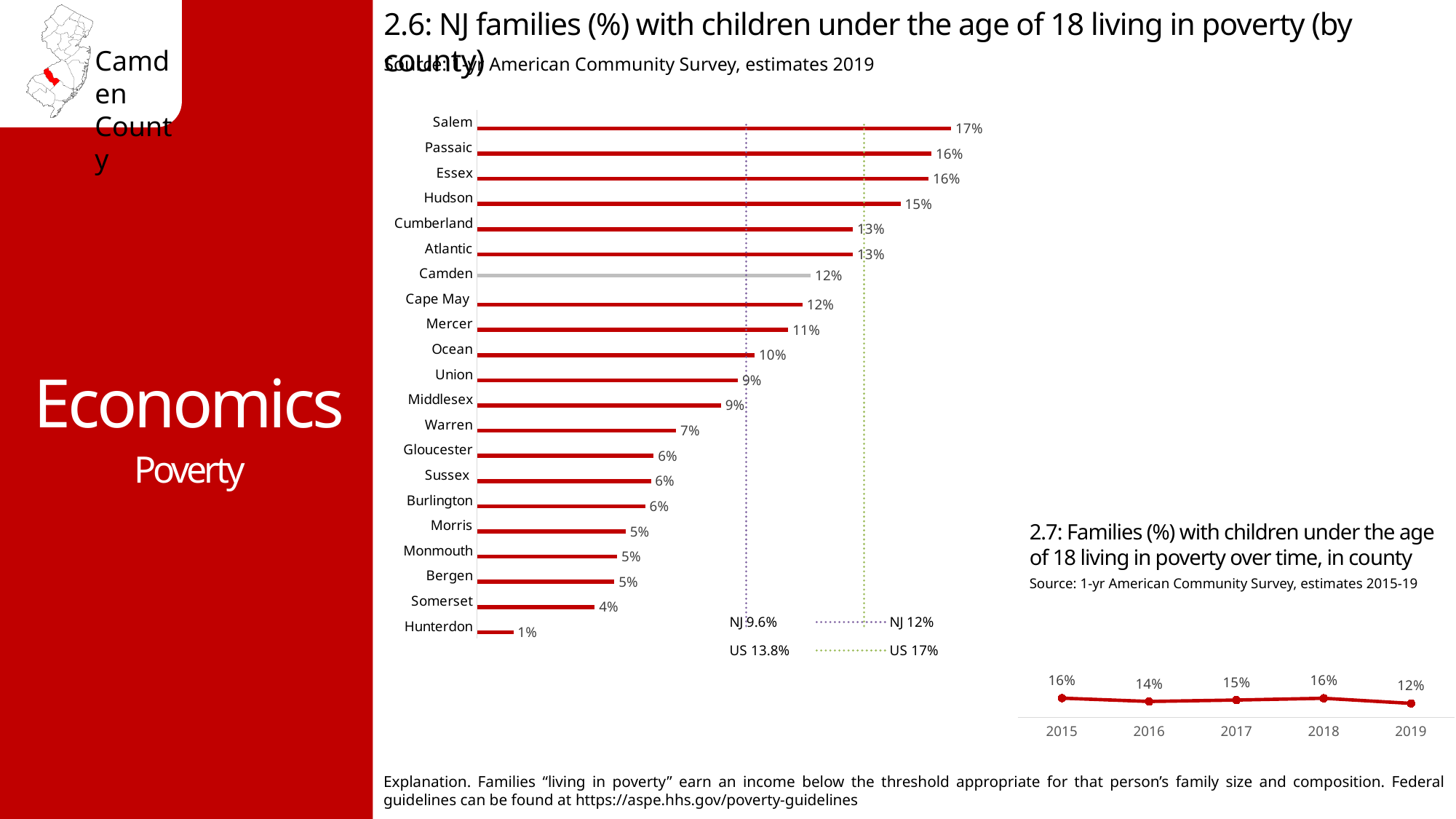
In chart 2.7 (poverty over time, in county), what is the difference between the values for 2018 and 2019? 4% In chart 2.7 (poverty over time, in county), which year has the lowest value? 2019 In chart 2.6 (by county), which is larger, the value for Mercer or the value for Warren? Mercer In chart 2.6 (by county), which county has the lowest value? Hunterdon In chart 2.6 (by county), what is the value for Hudson? 15% What kind of chart is chart 2.6 (by county)? Bar chart In chart 2.6 (by county), which county has the highest value? Salem In chart 2.7 (poverty over time, in county), what is the value for 2017? 15% In chart 2.6 (by county), how many counties are plotted? 21 In chart 2.6 (by county), what is the difference between the values for Salem and Hunterdon? 16% In chart 2.6 (NJ families with children under 18 living in poverty by county), what is the value for Camden? 12%